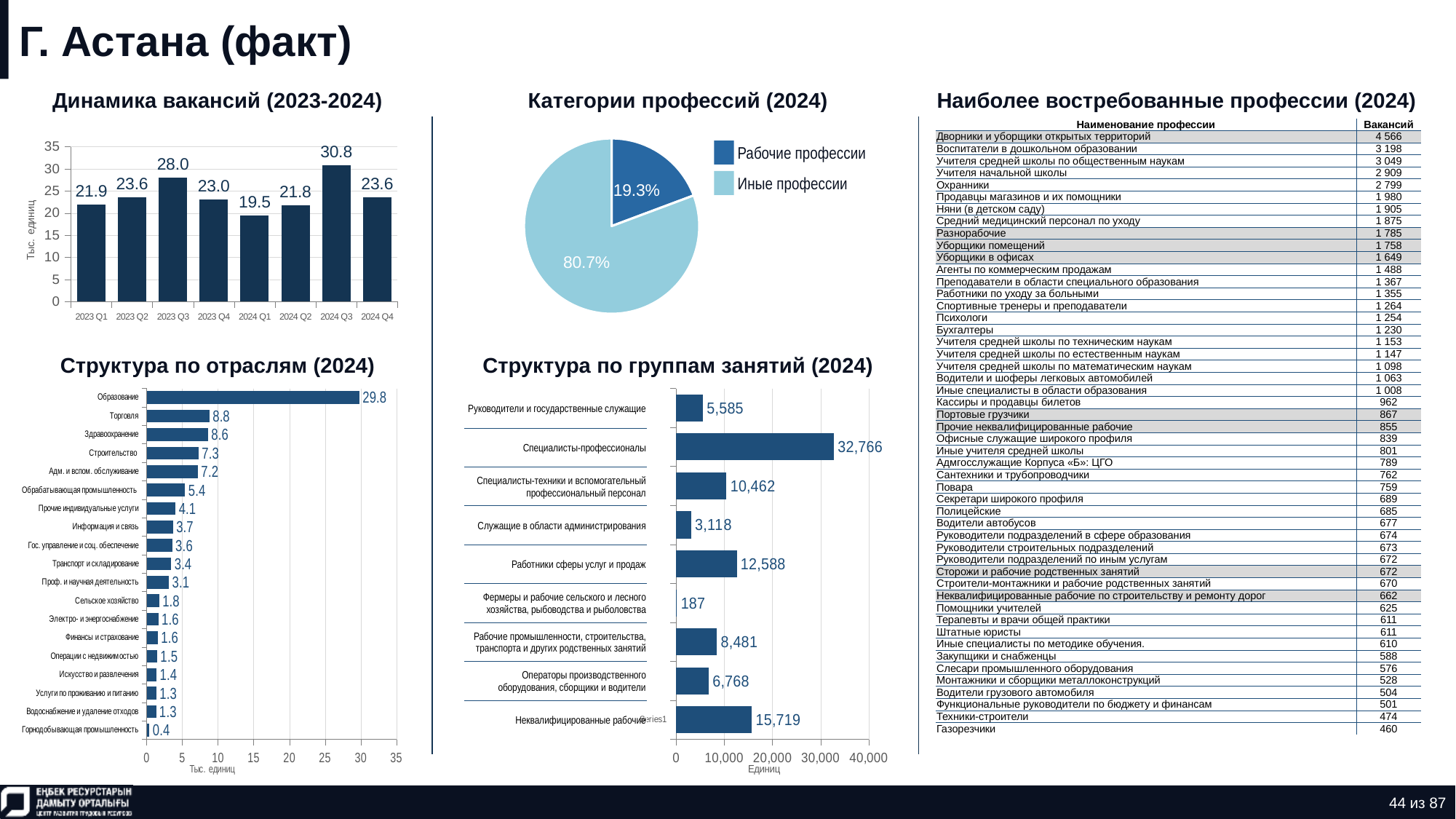
In the 'Категории профессий (2024)' pie chart, what share is 'Рабочие профессии'? 19.3% In the 'Динамика вакансий (2023-2024)' chart, what is the value for 2024 Q3? 30.8 In the 'Структура по группам занятий (2024)' chart, which is larger: 'Неквалифицированные рабочие' or 'Специалисты-техники и вспомогательный профессиональный персонал'? Неквалифицированные рабочие In the 'Динамика вакансий (2023-2024)' chart, what is the difference between 2023 Q3 and 2023 Q4? 5.0 In the 'Структура по группам занятий (2024)' chart, which category has the lowest value? Фермеры и рабочие сельского и лесного хозяйства, рыбоводства и рыболовства How many entries does the legend of the 'Категории профессий (2024)' chart list? 2 In the 'Структура по группам занятий (2024)' chart, what is the value for 'Работники сферы услуг и продаж'? 12,588 In the 'Структура по отраслям (2024)' chart, which category has the highest value? Образование In the 'Структура по отраслям (2024)' chart, what is the value for 'Торговля'? 8.8 What kind of chart is 'Структура по отраслям (2024)'? bar chart How many quarters are shown in the 'Динамика вакансий (2023-2024)' chart? 8 In the 'Динамика вакансий (2023-2024)' chart, which quarter has the lowest value? 2024 Q1